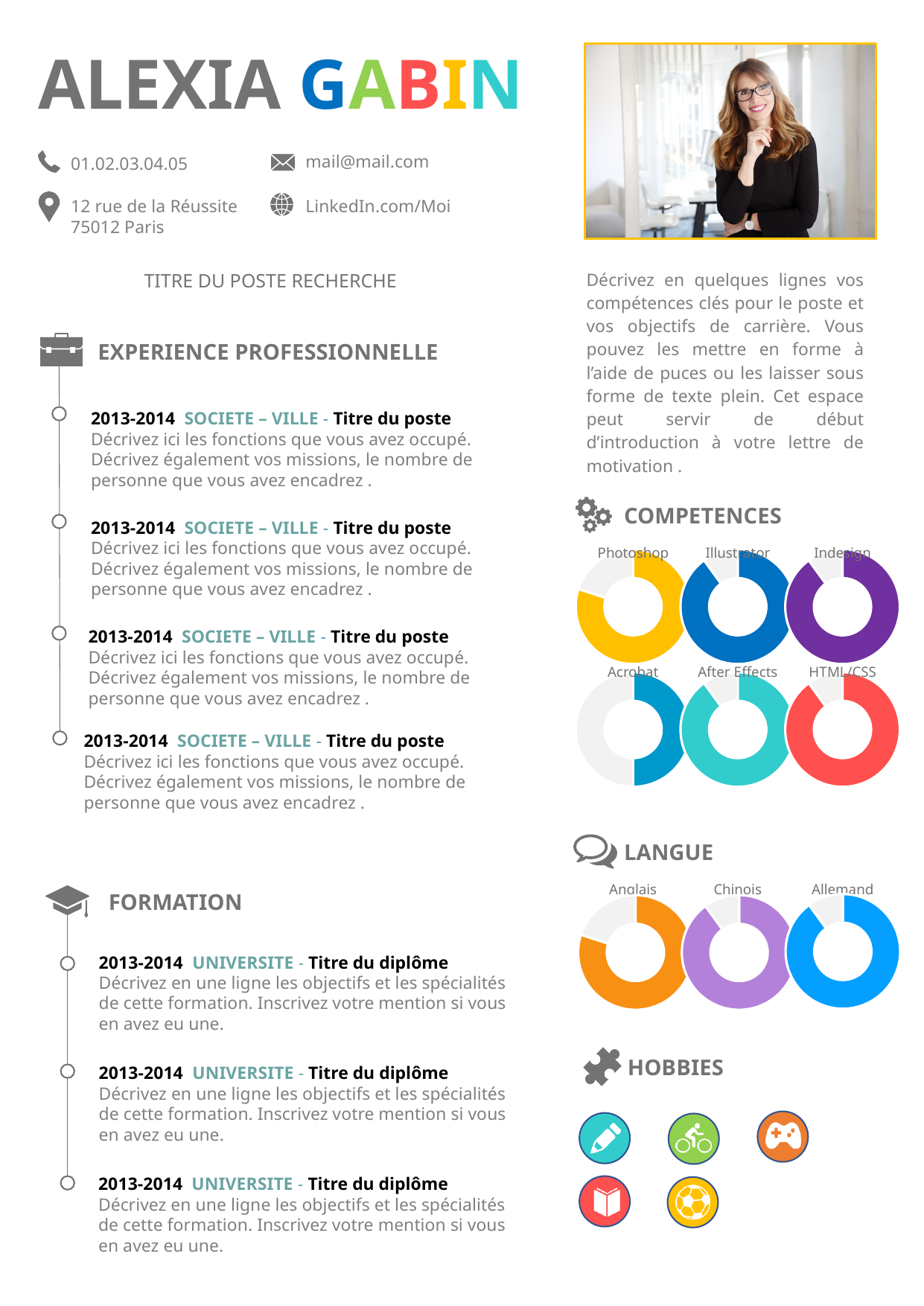
How many donut charts are shown in the COMPETENCES section? 6 In the COMPETENCES section, which donut chart has a larger filled portion: Acrobat or Illustrator? Illustrator In the LANGUE section, which donut chart has a larger filled portion: Anglais or Chinois? Chinois What colour is the filled portion of the Photoshop donut chart? Yellow In the COMPETENCES section, which skill has the smallest filled portion of its donut chart? Acrobat What kind of chart is used to show the Photoshop skill level in the COMPETENCES section? Donut chart In the LANGUE section, which language's donut chart is orange? Anglais How many donut charts are shown in the LANGUE section? 3